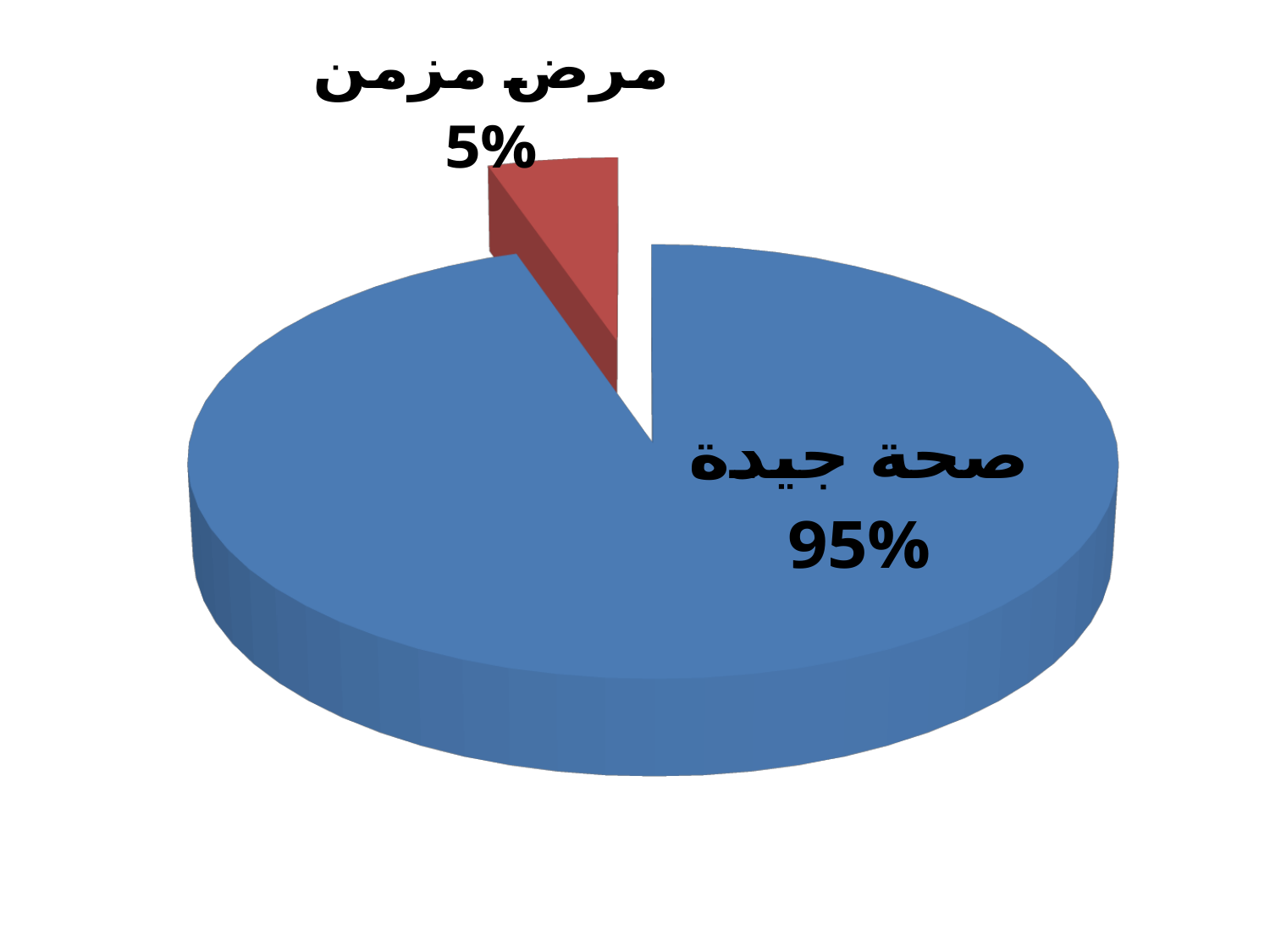
What colour is the "صحة جيدة" slice? blue What percentage is shown for the slice labelled "مرض مزمن"? 5% What percentage is shown for the slice labelled "صحة جيدة"? 95% What is the difference in percentage points between the "صحة جيدة" slice and the "مرض مزمن" slice? 90 What colour is the "مرض مزمن" slice? red Which slice of the pie chart is the largest? صحة جيدة How many slices does the pie chart have? 2 What kind of chart is shown on the slide? pie chart Which is larger, the "مرض مزمن" slice or the "صحة جيدة" slice? صحة جيدة Which slice of the pie chart is the smallest? مرض مزمن What share of the pie does the "مرض مزمن" slice represent? 5%